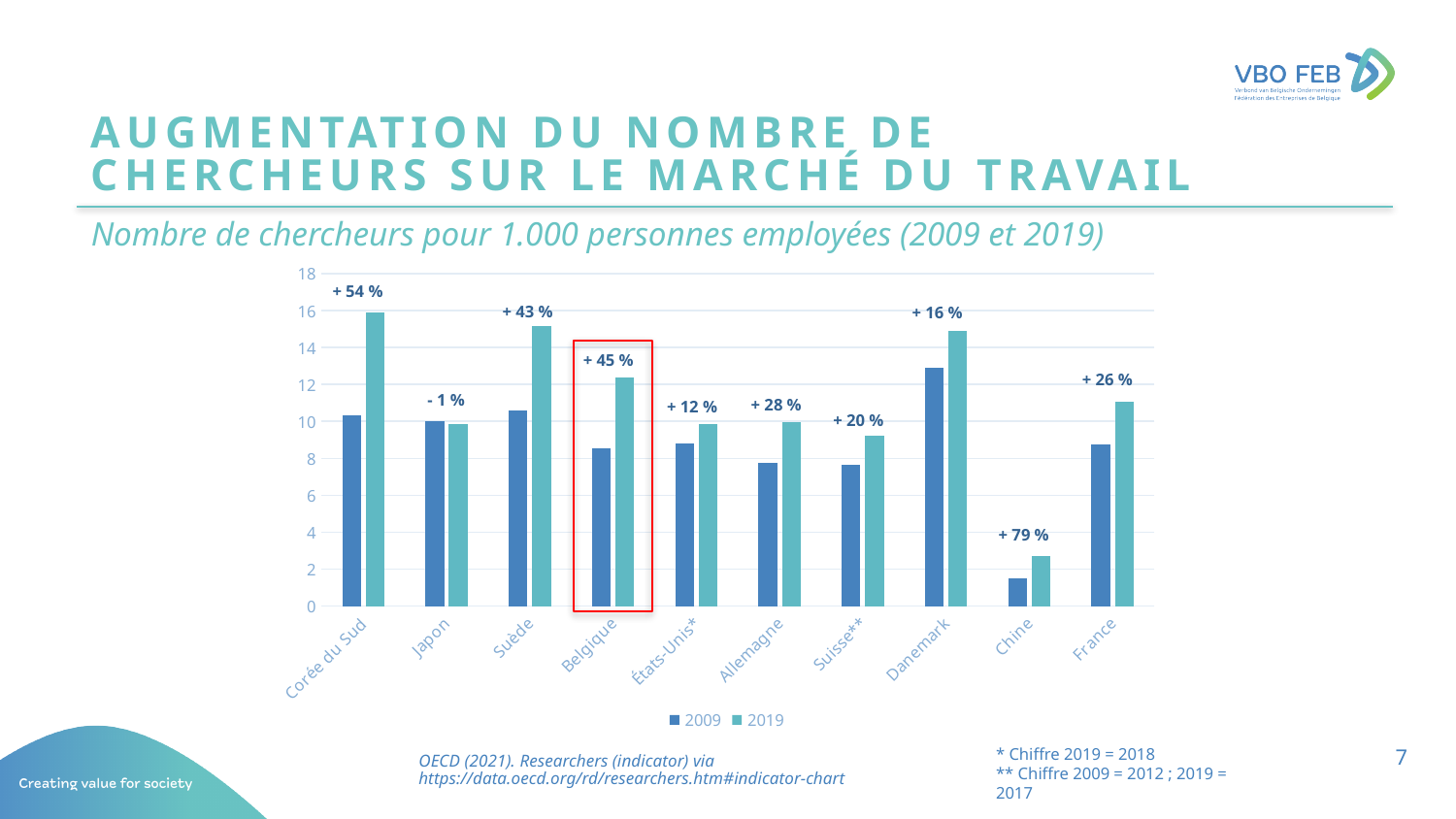
What percentage change is shown for Chine? + 79 % What percentage change is shown for Japon? - 1 % Which is larger: the 2019 value for Corée du Sud or the 2019 value for Japon? Corée du Sud Which country shows the largest percentage increase label? Chine How many countries are shown on the x axis? 10 Is the 2019 value for France greater or less than 10? greater Which country has the lowest 2019 value? Chine Is the 2019 value for Chine greater or less than 4? less How many series does the legend list? 2 Is the 2009 value for Belgique greater or less than 10? less Which country has the highest 2009 value? Danemark What percentage change is shown above the bars for Belgique? + 45 %